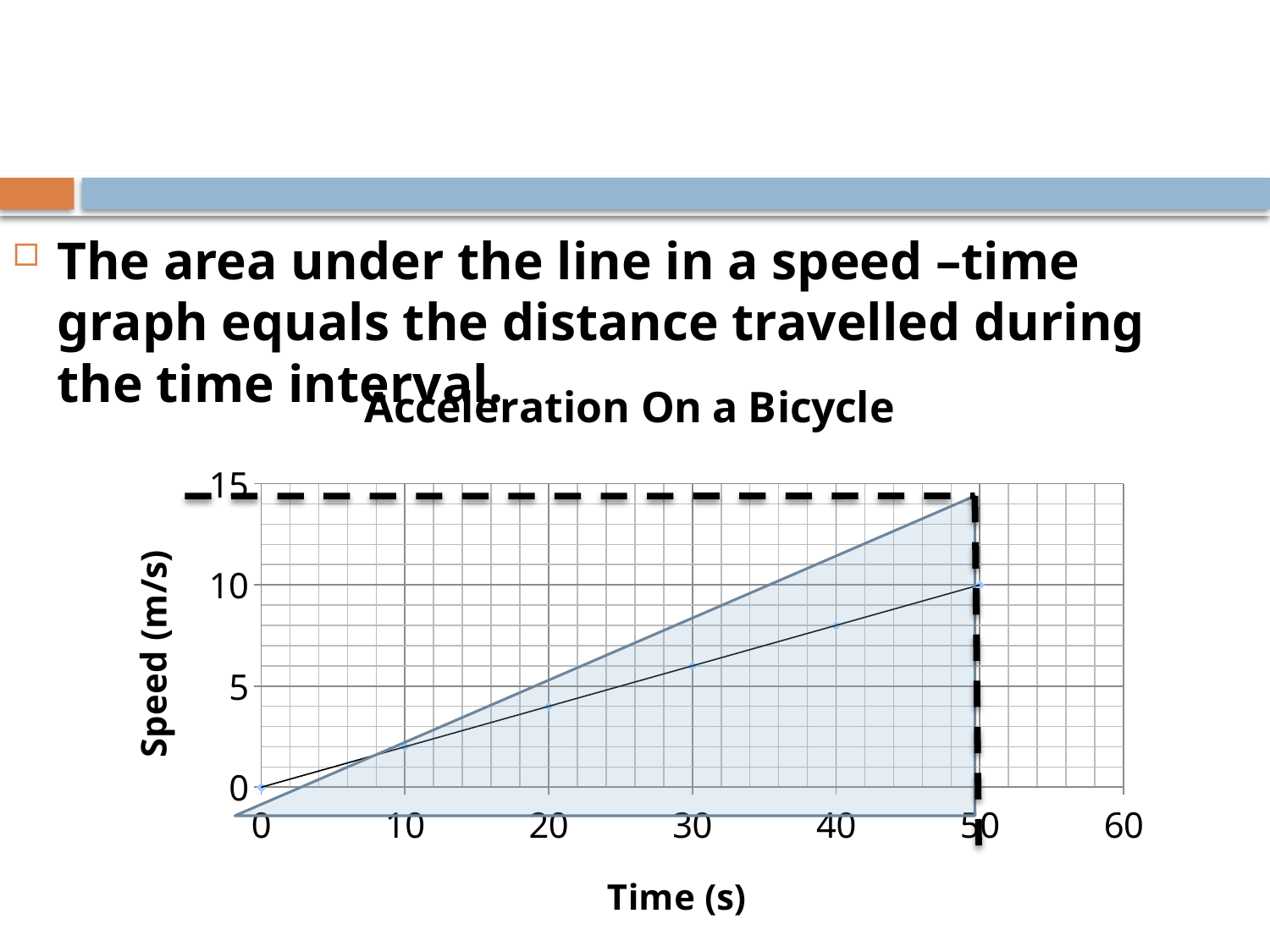
What is the label of the vertical axis? Speed (m/s) At which time is the speed highest? 50 What is the speed at a time of 0 s? 0 Is the speed at 10 s greater or less than 5? less What kind of chart is shown on the slide? line chart At which time is the speed lowest? 0 What is the title of the chart? Acceleration On a Bicycle Is the speed at 30 s greater or less than 5? greater Does the speed rise or fall as time increases along the x axis? rise What is the speed at a time of 50 s? 10 Is the speed at 40 s greater or less than 10? less Which is larger, the speed at 20 s or the speed at 40 s? 40 s